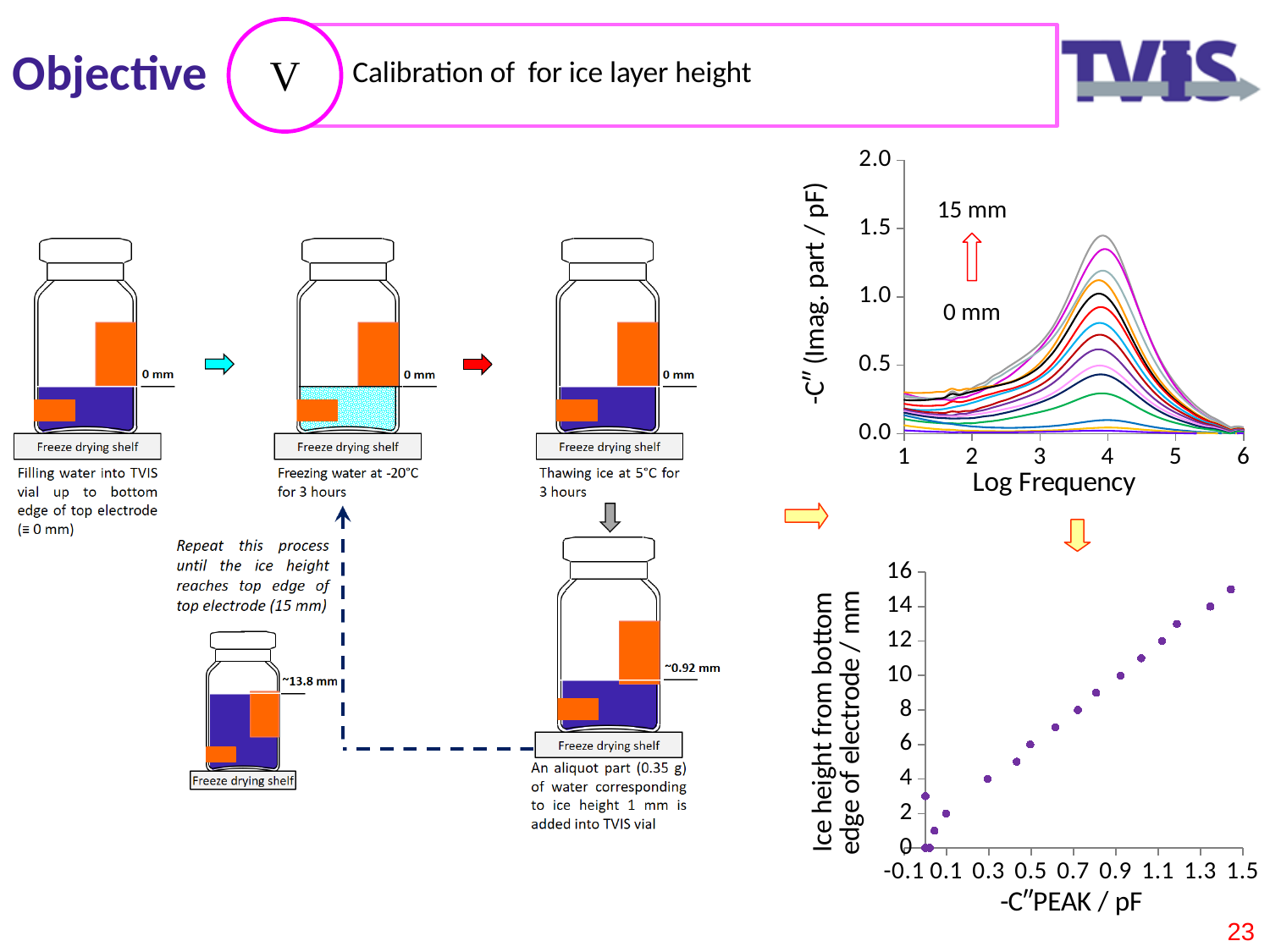
In the top-right chart, which ice height label is placed at the top of the arrow, 15 mm or 0 mm? 15 mm In the bottom-right chart, does ice height rise or fall as -C''PEAK increases? rise In the top-right chart, what is the maximum value shown on the y axis? 2.0 In the top-right chart, is the peak value of the lowest curve greater or less than 0.5? less In the bottom-right chart, what is the label of the x axis? -C''PEAK / pF In the bottom-right chart, is the ice height of the point at -C''PEAK of about 0.3 greater or less than 8? less What kind of chart is the bottom-right chart plotting ice height against -C''PEAK? scatter plot In the top-right chart, what is the label of the x axis? Log Frequency What kind of chart is the top-right chart plotting -C'' against Log Frequency? line chart In the top-right chart, do the curves rise or fall as log frequency increases from 4 to 6? fall In the top-right chart, is the peak value of the highest curve greater or less than 1.0? greater